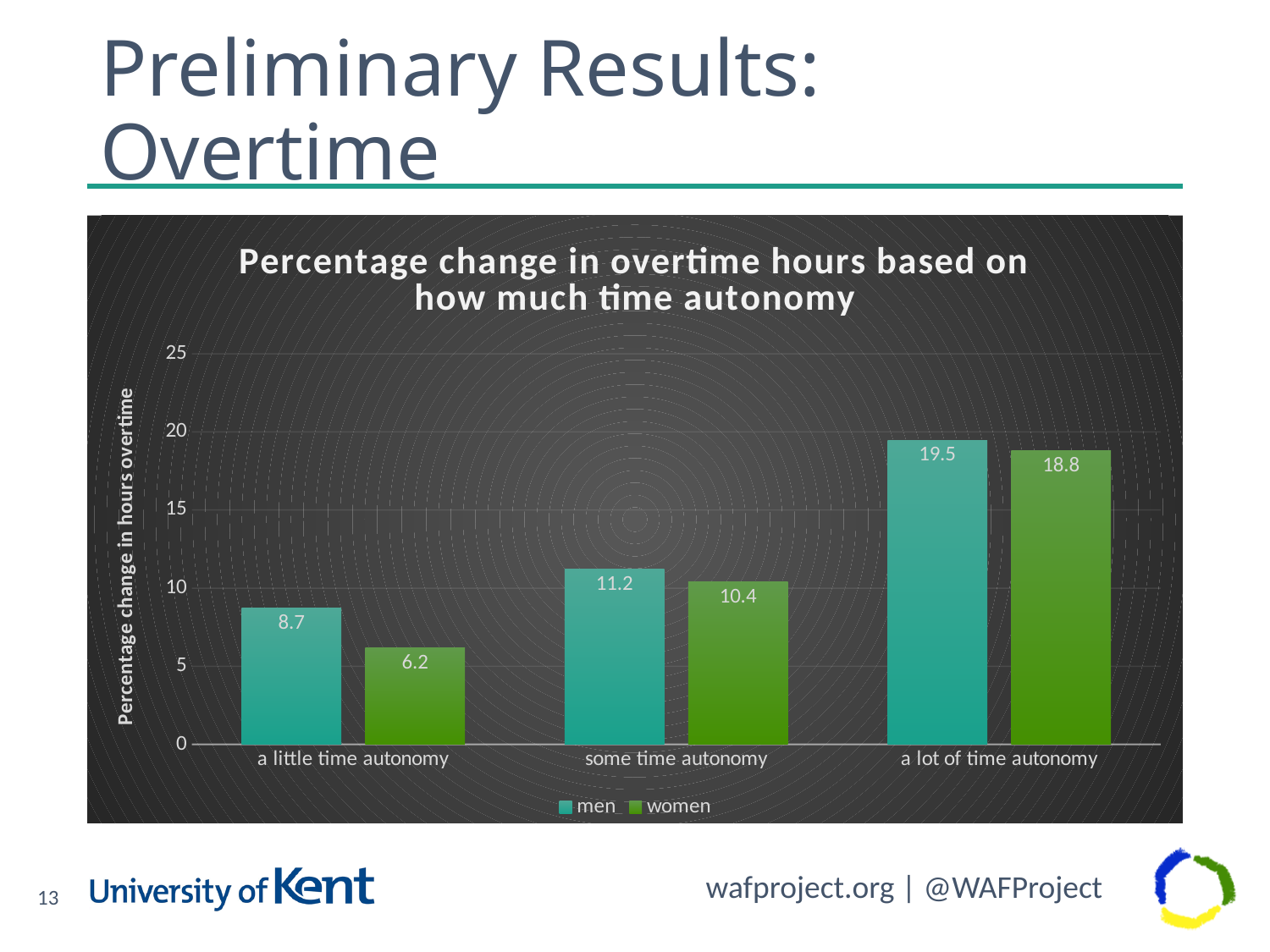
Do the values for women rise or fall from a little time autonomy to a lot of time autonomy? rise What is the value for women with a lot of time autonomy? 18.8 What is the value for women with some time autonomy? 10.4 How many categories are shown on the x axis? 3 What kind of chart is shown on the slide? bar chart What is the difference between the men values for a lot of time autonomy and some time autonomy? 8.3 Which category has the highest value for men? a lot of time autonomy What is the value for men with a little time autonomy? 8.7 What is the difference between the men and women values for a little time autonomy? 2.5 How many series does the legend list? 2 Which is larger for some time autonomy, the value for men or for women? men Which category has the lowest value for women? a little time autonomy